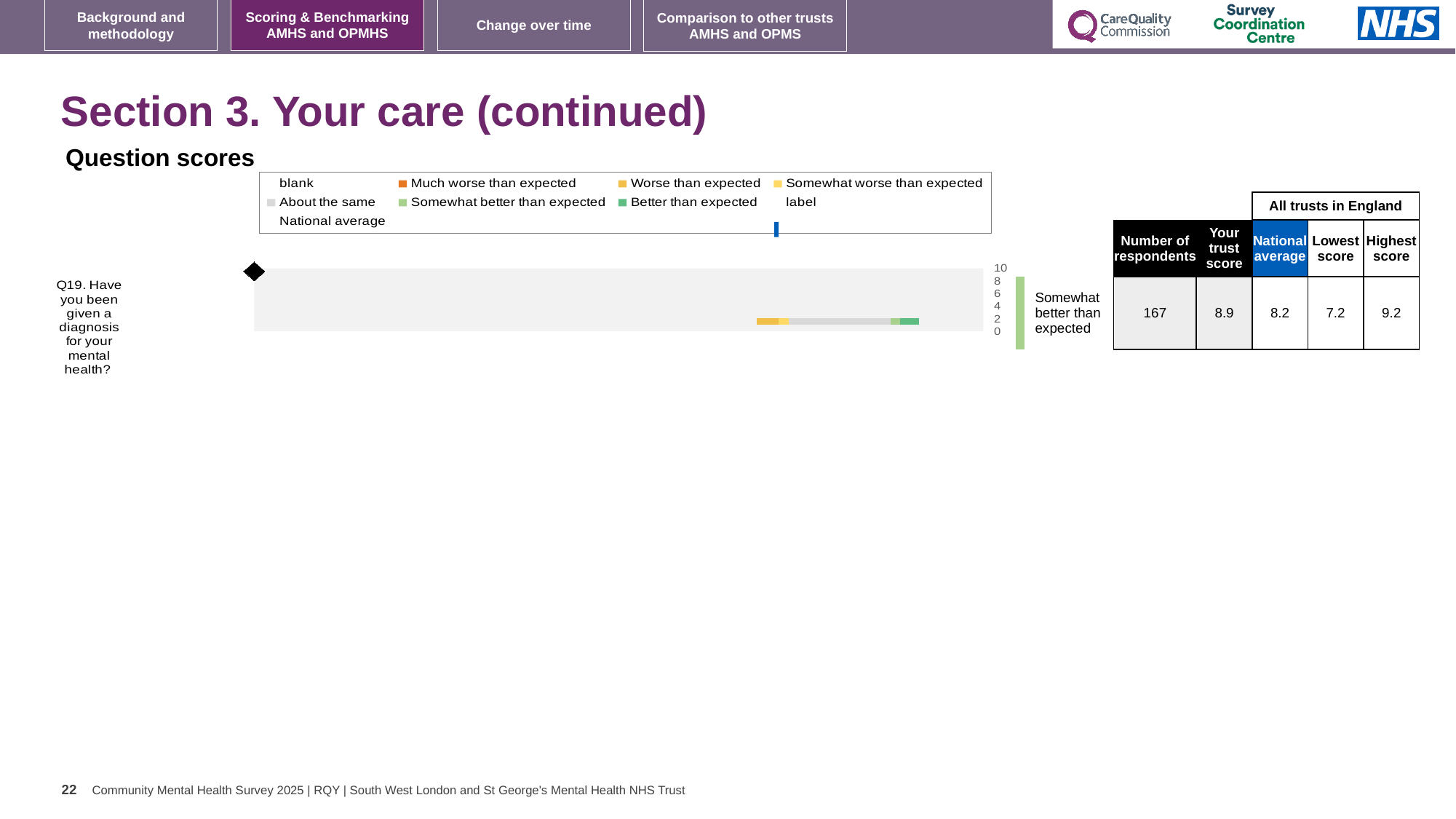
By how much does the trust score for Q19 exceed the national average? 0.7 How many respondents answered Q19? 167 How many survey questions are plotted in the 'Question scores' chart? 1 What kind of chart is shown under 'Question scores'? bar chart What is the difference between the highest and lowest scores for Q19 across all trusts in England? 2.0 What is the 'Your trust score' for Q19 (Have you been given a diagnosis for your mental health?)? 8.9 What benchmark category label is shown next to the Q19 bar? Somewhat better than expected Which is larger for Q19: the trust score or the national average? Your trust score What is the national average score for Q19? 8.2 What is the highest score among all trusts in England for Q19? 9.2 What is the lowest score among all trusts in England for Q19? 7.2 Is the trust score for Q19 greater or less than 8? greater